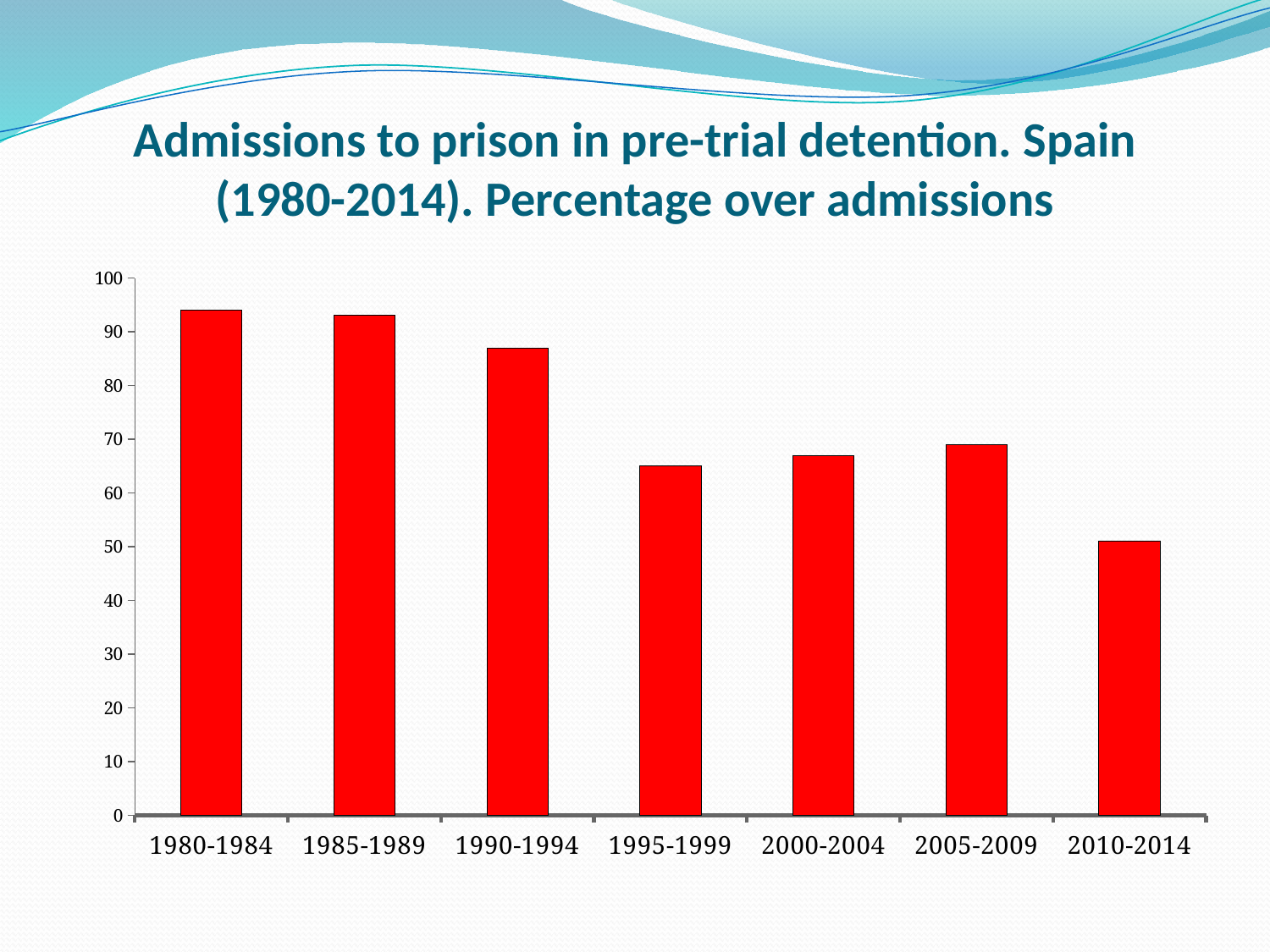
Is the value for 2010-2014 greater or less than 60? less Is the value for 1990-1994 greater or less than 80? greater Which period has the lowest percentage of admissions in pre-trial detention? 2010-2014 How many time periods are shown on the x axis of the chart? 7 Is the value for 1995-1999 greater or less than 70? less What is the title of the chart on the slide? Admissions to prison in pre-trial detention. Spain (1980-2014). Percentage over admissions Which is larger, the value for 2005-2009 or the value for 2010-2014? 2005-2009 What kind of chart is shown on the slide? bar chart Overall, do the values rise or fall from 1980-1984 to 2010-2014? fall Which is larger, the value for 1990-1994 or the value for 1995-1999? 1990-1994